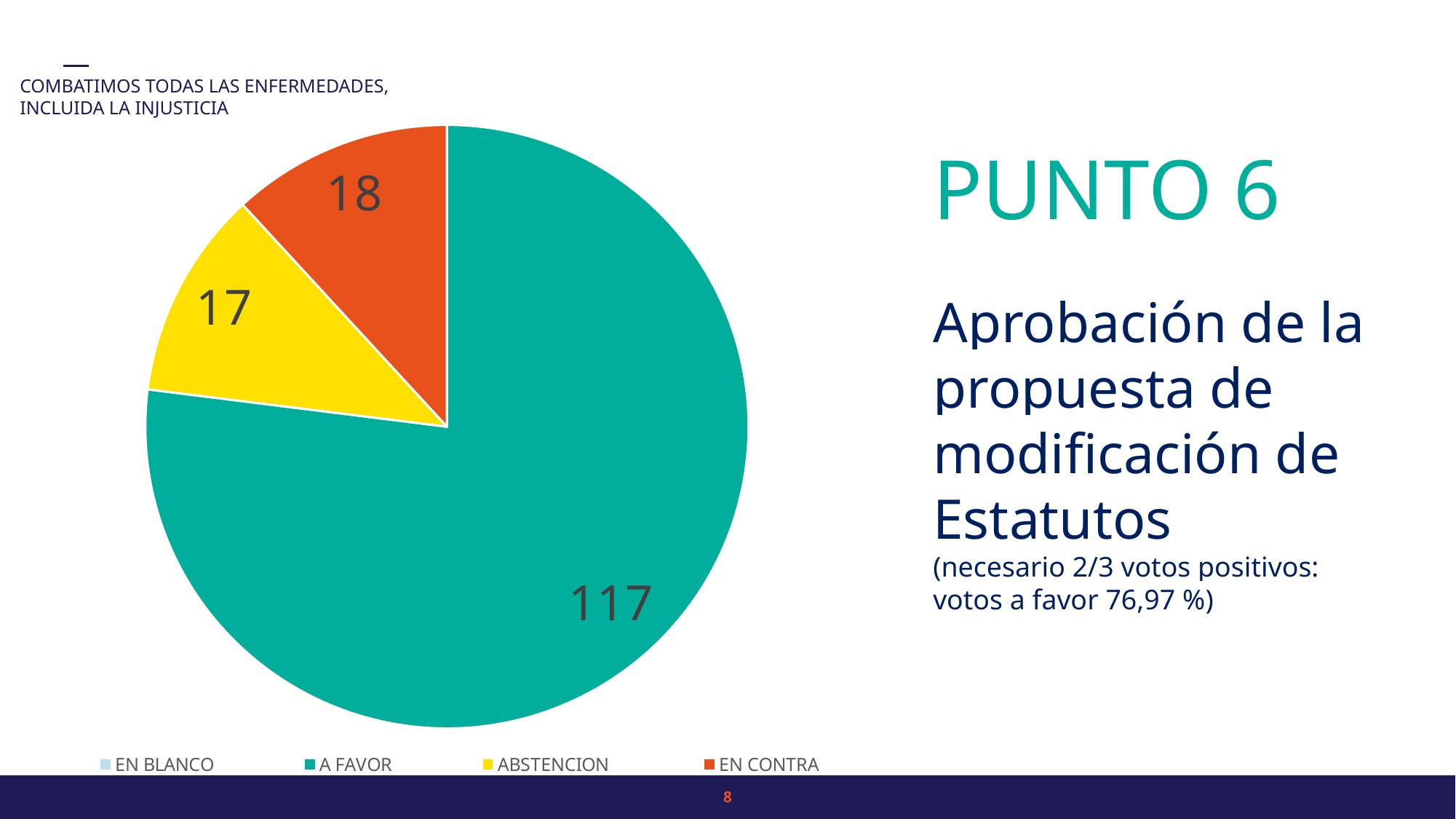
What colour is the A FAVOR slice in the pie chart? teal (green) What kind of chart is shown on the slide? pie chart Which category has the largest slice of the pie chart? A FAVOR What is the difference between the A FAVOR votes and the EN CONTRA votes? 99 How many categories does the legend of the pie chart list? 4 How many votes are shown for ABSTENCION in the pie chart? 17 What is the difference between the EN CONTRA votes and the ABSTENCION votes? 1 Which legend entry is shown in yellow? ABSTENCION Which is larger, the value for A FAVOR or the value for ABSTENCION? A FAVOR How many votes are shown for A FAVOR in the pie chart? 117 How many votes are shown for EN CONTRA in the pie chart? 18 According to the slide, what percentage of the votes were A FAVOR? 76,97 %